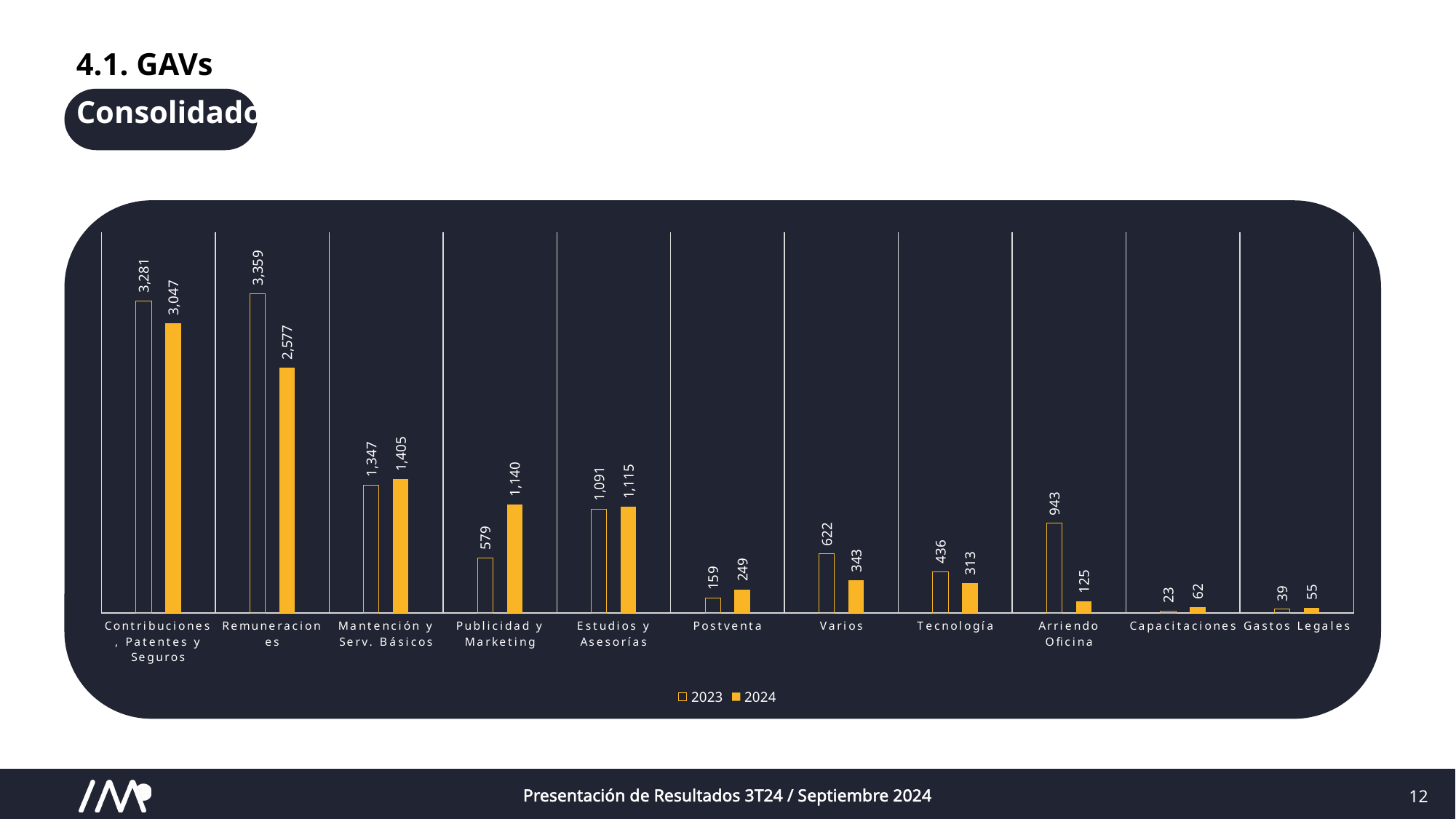
What is the 2023 value for Arriendo Oficina? 943 How many categories are shown on the x axis? 11 What is the 2024 value for Postventa? 249 Which category has the lowest 2024 value? Gastos Legales Which is larger for Varios, the 2023 value or the 2024 value? 2023 What is the difference between the 2024 and 2023 values for Publicidad y Marketing? 561 What is the difference between the 2023 and 2024 values for Remuneraciones? 782 How many series does the legend list? 2 Which is larger for Mantención y Serv. Básicos, the 2023 value or the 2024 value? 2024 Which category has the highest 2023 value? Remuneraciones What kind of chart is shown on the slide? Bar chart What is the 2024 value for Publicidad y Marketing? 1,140